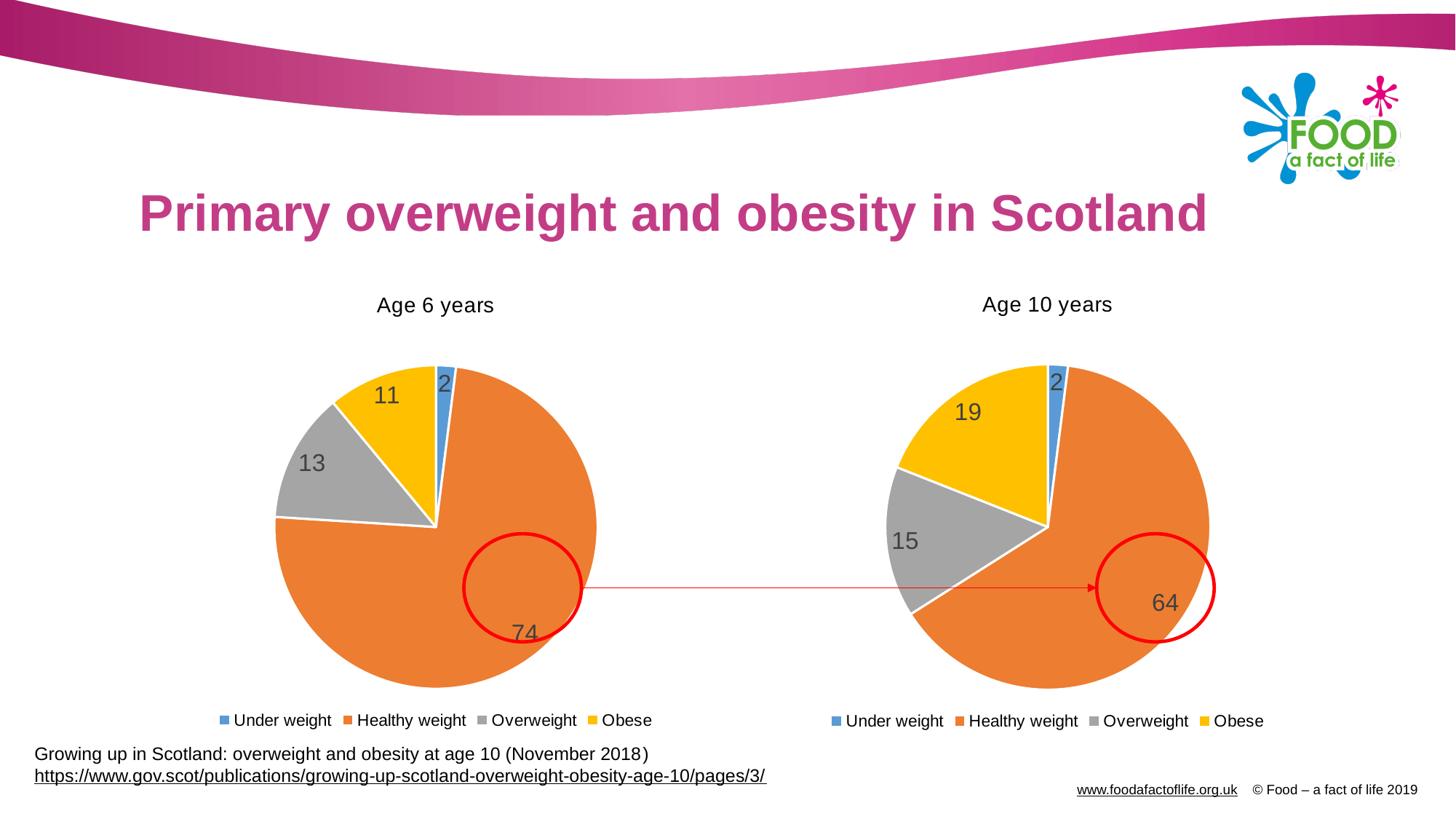
Is the Obese slice larger in the 'Age 6 years' chart or the 'Age 10 years' chart? Age 10 years In the 'Age 6 years' chart, what share of the pie does Healthy weight represent? 74% How many categories does the 'Age 6 years' pie chart have? 4 In the 'Age 10 years' chart, which category has the smallest slice? Under weight In the 'Age 10 years' chart, what is the value for Overweight? 15 In the 'Age 10 years' chart, what colour is the Overweight slice? Grey What is the difference between the Healthy weight value in the 'Age 6 years' chart and the Healthy weight value in the 'Age 10 years' chart? 10 What type of chart is used for 'Age 10 years'? Pie chart In the 'Age 6 years' chart, what is the value for Healthy weight? 74 In the 'Age 6 years' chart, what is the difference between the Overweight and Obese values? 2 In the 'Age 10 years' chart, what is the value for Obese? 19 In the 'Age 6 years' chart, which category has the largest slice? Healthy weight